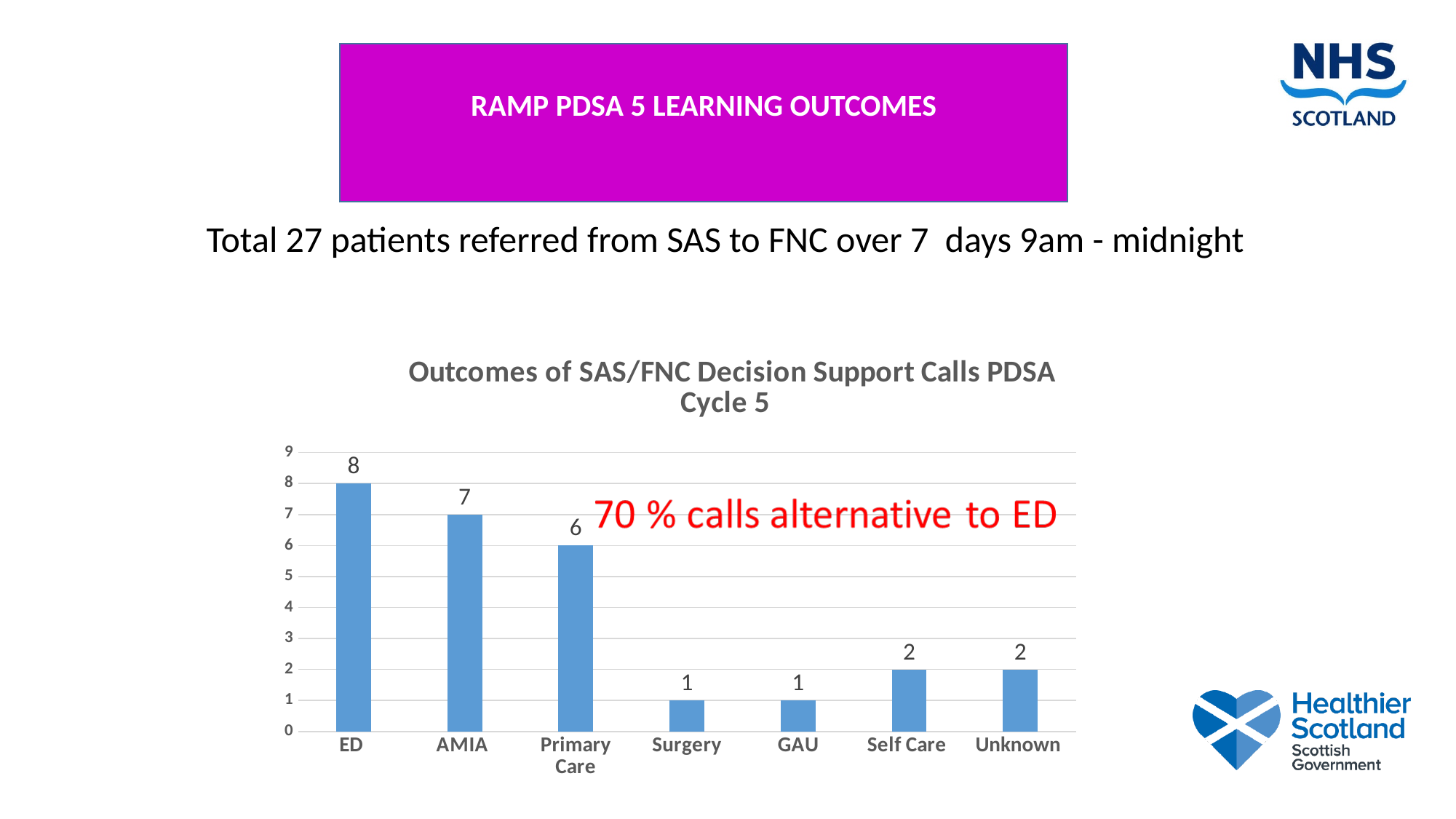
Which category has the highest value? ED What is the difference between the values for ED and Primary Care? 2 What is the title of the chart? Outcomes of SAS/FNC Decision Support Calls PDSA Cycle 5 What does the red text on the chart say? 70 % calls alternative to ED What is the value for Self Care? 2 What kind of chart is shown on the slide? Bar chart What is the value for Primary Care? 6 What is the value for AMIA? 7 How many categories are shown on the x axis? 7 What is the difference between the values for Surgery and Unknown? 1 What is the value for ED? 8 Which is larger, the value for AMIA or the value for Self Care? AMIA